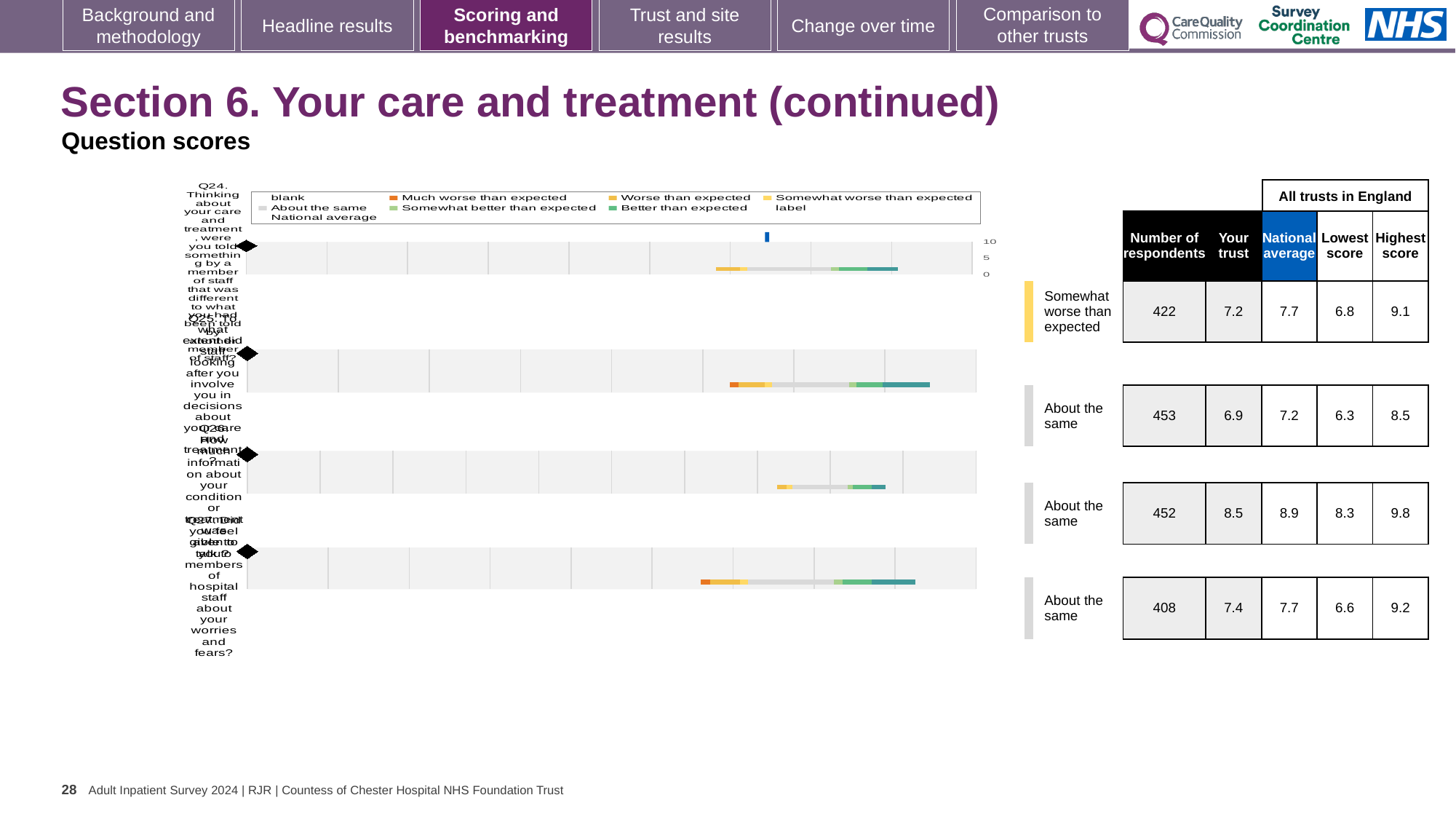
Which legend entry is shown in orange-red? Much worse than expected Which chart row has the highest trust score: the second row (6.9) or the third row (8.5)? third row What kind of chart is used to show the question scores on this slide? bar chart For the first chart row (Q24), what is the trust's score in the table? 7.2 What is the highest value shown on the chart's x axis? 10 How many question charts (rows) are plotted on the slide? 4 For the first chart row (Q24), what is the national average? 7.7 How many entries does the chart legend list? 9 For the first chart row (Q24), what benchmark category is the trust's score given? Somewhat worse than expected For the fourth chart row, what is the difference between the national average and the trust's score? 0.3 For the third chart row, what is the highest score across all trusts in England? 9.8 For the second chart row, how many respondents are listed? 453